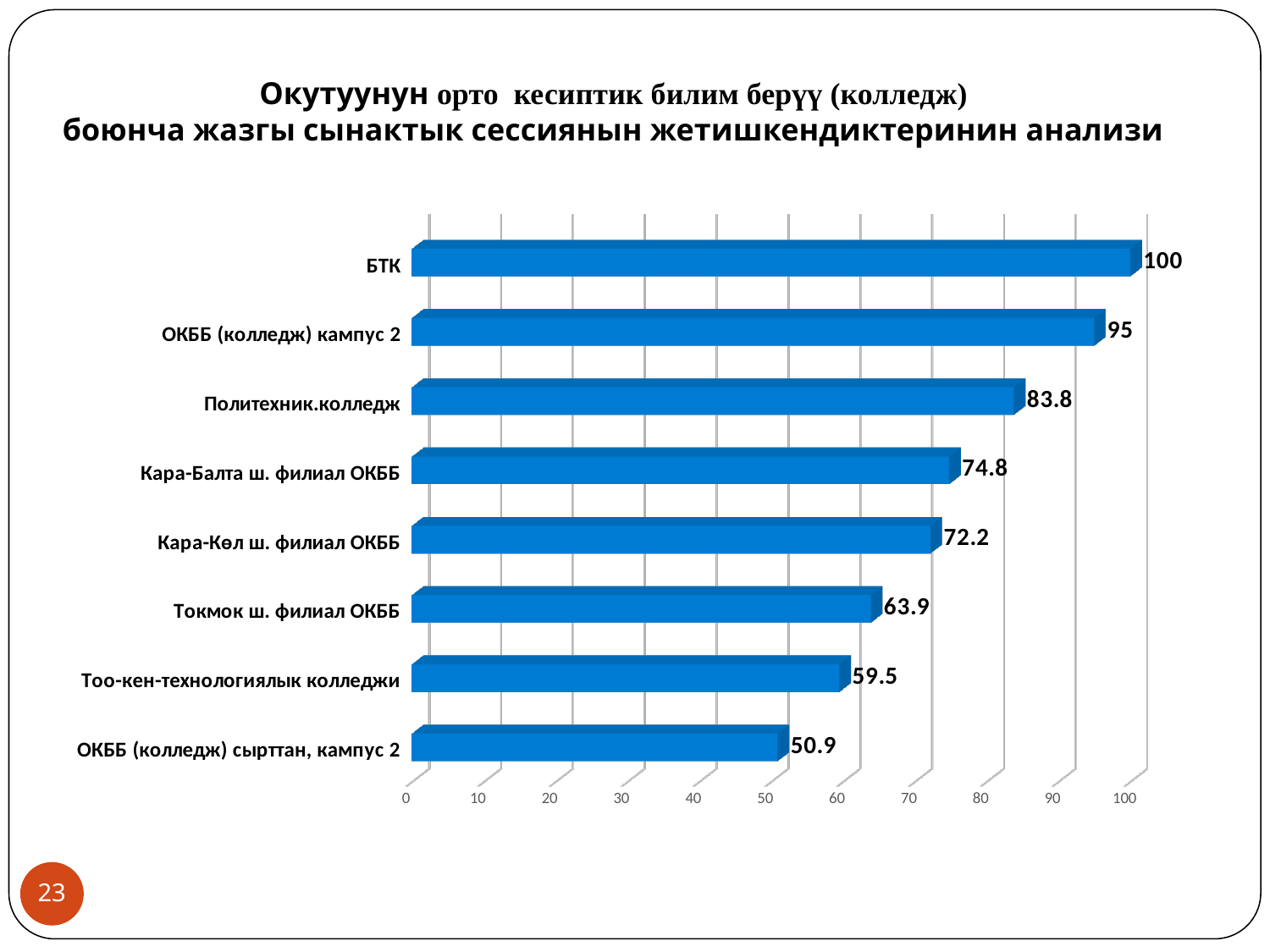
Which is larger, the value for Кара-Көл ш. филиал ОКББ or the value for Тоо-кен-технологиялык колледжи? Кара-Көл ш. филиал ОКББ What is the value for БТК? 100 What kind of chart is shown on the slide? bar chart What is the value for Токмок ш. филиал ОКББ? 63.9 Which category has the lowest value? ОКББ (колледж) сырттан, кампус 2 Is the value for Тоо-кен-технологиялык колледжи greater or less than 60? less How many categories are shown in the chart? 8 What is the value for Политехник.колледж? 83.8 Which category has the highest value? БТК What is the highest tick value shown on the horizontal axis? 100 What is the difference between the values for ОКББ (колледж) кампус 2 and Кара-Балта ш. филиал ОКББ? 20.2 What is the value for ОКББ (колледж) сырттан, кампус 2? 50.9